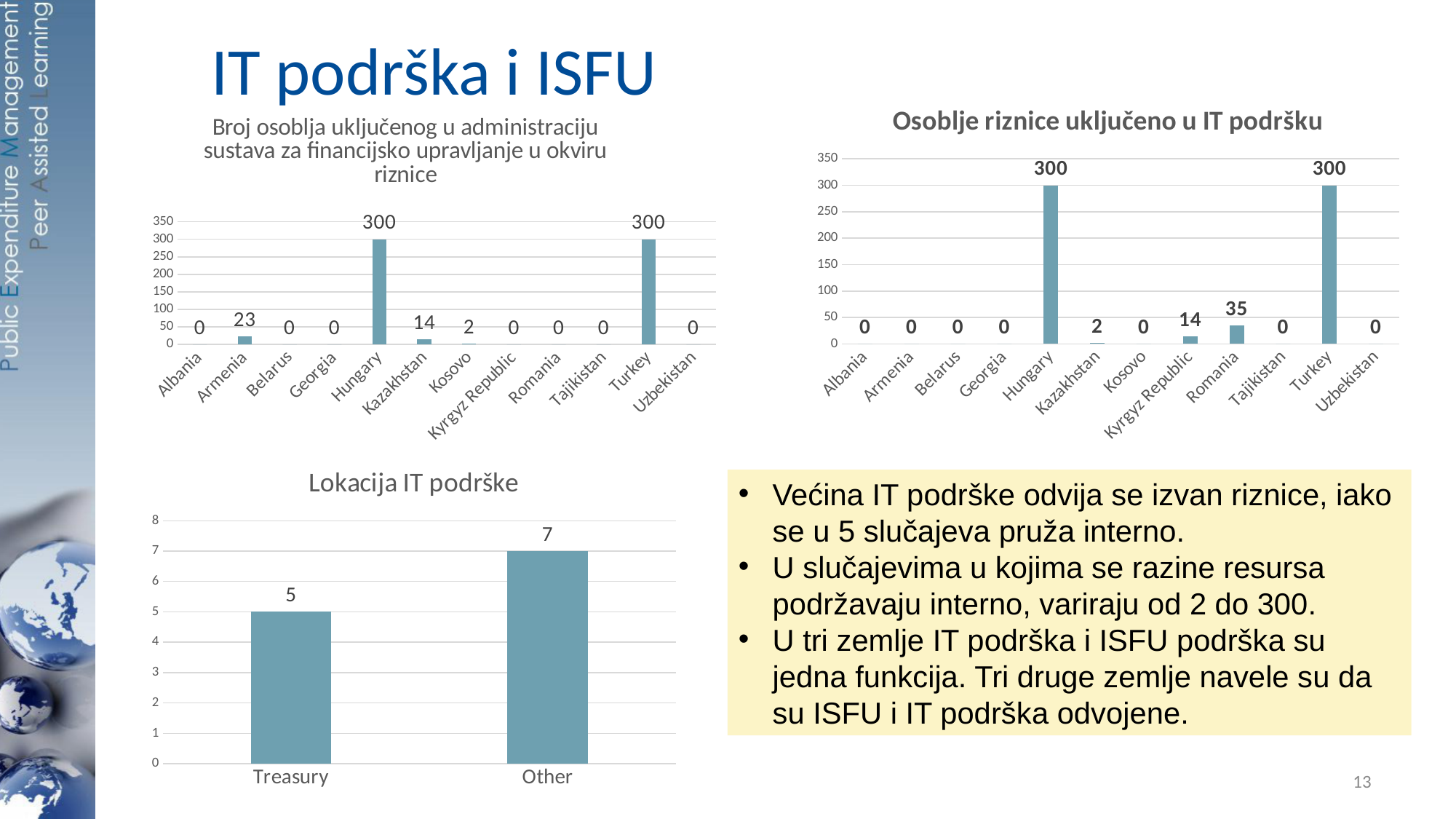
In the chart titled 'Lokacija IT podrške', what is the difference between the values for Other and Treasury? 2 In the chart titled 'Osoblje riznice uključeno u IT podršku', what is the difference between the values for Romania and Kazakhstan? 33 In the chart titled 'Osoblje riznice uključeno u IT podršku', which two countries have a value of 300? Hungary and Turkey In the chart titled 'Lokacija IT podrške', what is the value for Treasury? 5 What kind of chart is 'Lokacija IT podrške'? Bar chart In the top-left chart ('Broj osoblja uključenog u administraciju sustava...'), what is the value for Kazakhstan? 14 In the chart titled 'Lokacija IT podrške', which category has the higher value? Other In the chart titled 'Osoblje riznice uključeno u IT podršku', what is the value for Romania? 35 In the top-left chart ('Broj osoblja uključenog u administraciju sustava...'), what is the value for Armenia? 23 In the chart titled 'Osoblje riznice uključeno u IT podršku', what is the value for Kyrgyz Republic? 14 How many countries are shown on the x axis of the chart titled 'Osoblje riznice uključeno u IT podršku'? 12 In the top-left chart ('Broj osoblja uključenog u administraciju sustava...'), which is larger, the value for Armenia or the value for Kosovo? Armenia